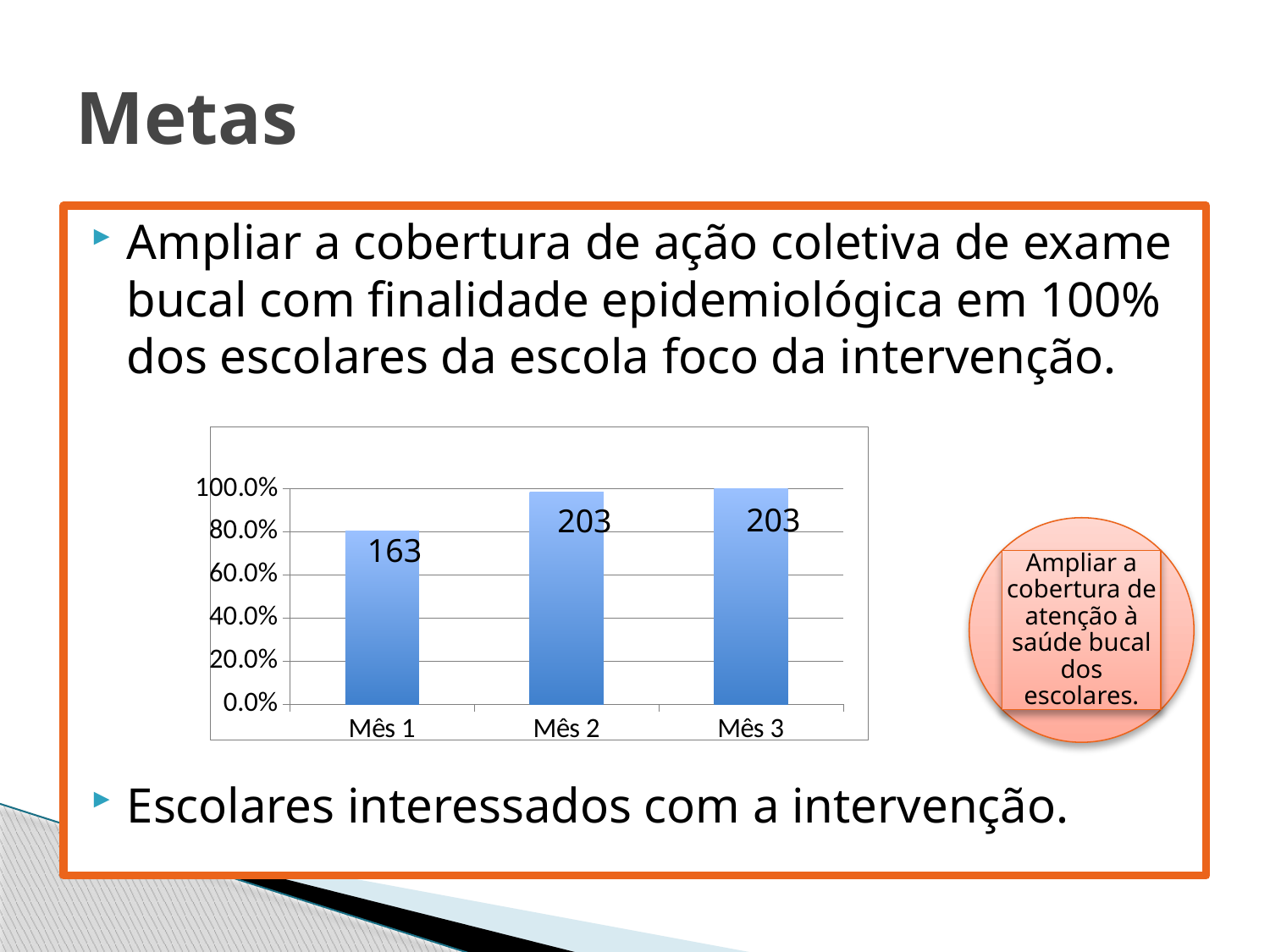
Is the bar for Mês 1 greater or less than 100.0% on the y axis? less What is the data label shown on the bar for Mês 2? 203 What is the data label shown on the bar for Mês 1? 163 What is the data label shown on the bar for Mês 3? 203 What is the difference between the data labels for Mês 2 and Mês 1? 40 What is the label of the first category on the x axis? Mês 1 Do the bar heights rise or fall from Mês 1 to Mês 2? rise Which bar is taller, Mês 1 or Mês 2? Mês 2 Is the bar for Mês 1 greater or less than 60.0% on the y axis? greater Which category has the lowest bar in the chart? Mês 1 What kind of chart is shown on the slide? bar chart How many categories are shown on the x axis of the chart? 3